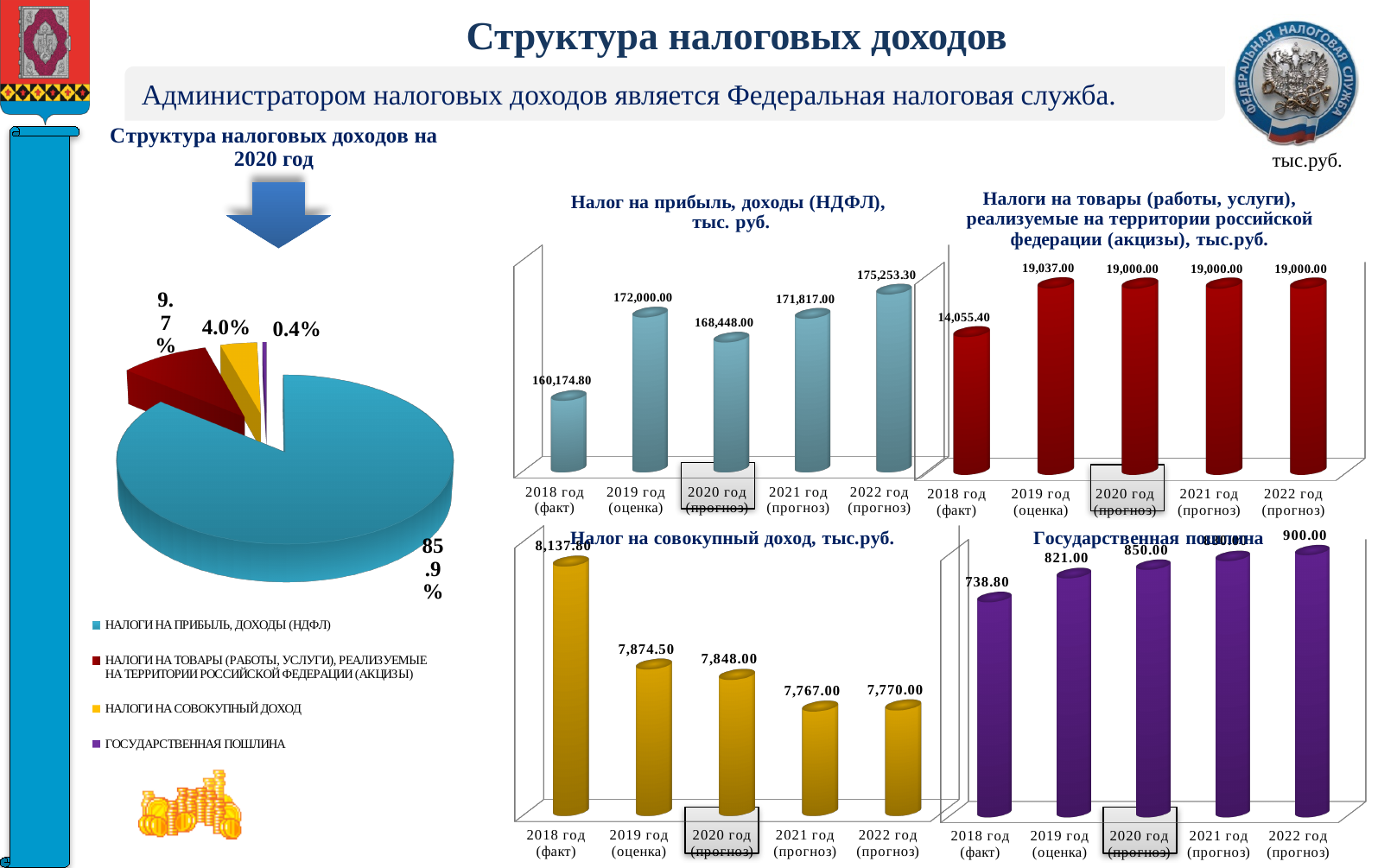
In the pie chart 'Структура налоговых доходов на 2020 год', what share is shown for the largest slice? 85.9% In the chart 'Государственная пошлина', what is the value for 2018 год (факт)? 738.80 In the chart 'Налог на прибыль, доходы (НДФЛ), тыс. руб.', what is the value for 2018 год (факт)? 160,174.80 In the chart 'Налоги на товары (работы, услуги), реализуемые на территории российской федерации (акцизы), тыс.руб.', what is the value for 2018 год (факт)? 14,055.40 In the chart 'Налоги на товары (работы, услуги), реализуемые на территории российской федерации (акцизы), тыс.руб.', which year has the highest value? 2019 год (оценка) In the chart 'Налог на прибыль, доходы (НДФЛ), тыс. руб.', what is the difference between the 2019 год (оценка) and 2020 год (прогноз) values? 3,552.00 In the chart 'Налог на совокупный доход, тыс.руб.', which year has the lowest value? 2021 год (прогноз) In the pie chart 'Структура налоговых доходов на 2020 год', what share is shown for the smallest slice? 0.4% In the chart 'Налог на совокупный доход, тыс.руб.', what is the value for 2020 год (прогноз)? 7,848.00 How many entries does the legend of the pie chart 'Структура налоговых доходов на 2020 год' list? 4 In the chart 'Налог на прибыль, доходы (НДФЛ), тыс. руб.', which year has the highest value? 2022 год (прогноз) In the chart 'Государственная пошлина', do the values rise or fall from 2018 to 2022? rise